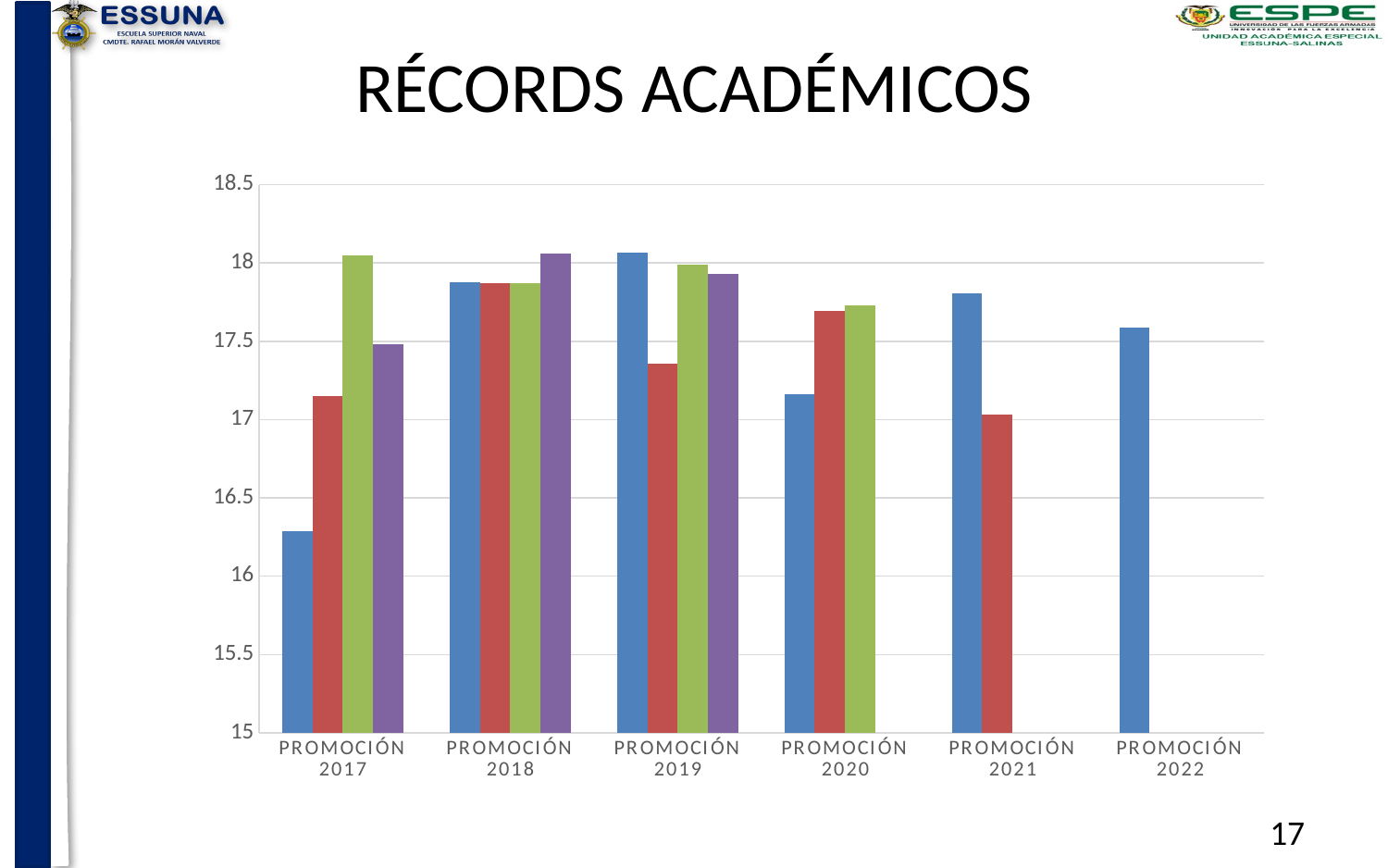
Is the value of the blue bar for PROMOCIÓN 2020 greater or less than 17? greater Is the value of the blue bar for PROMOCIÓN 2019 greater or less than 18? greater Is the value of the blue bar for PROMOCIÓN 2017 greater or less than 16.5? less What kind of chart is shown on the slide? bar chart Which promoción has the lowest blue bar? PROMOCIÓN 2017 How many bars are plotted for PROMOCIÓN 2022? 1 How many categories (promociones) are shown on the x axis? 6 Which is larger, the red bar for PROMOCIÓN 2017 or the red bar for PROMOCIÓN 2018? PROMOCIÓN 2018 What is the title of the chart? RÉCORDS ACADÉMICOS How many bars are plotted for PROMOCIÓN 2017? 4